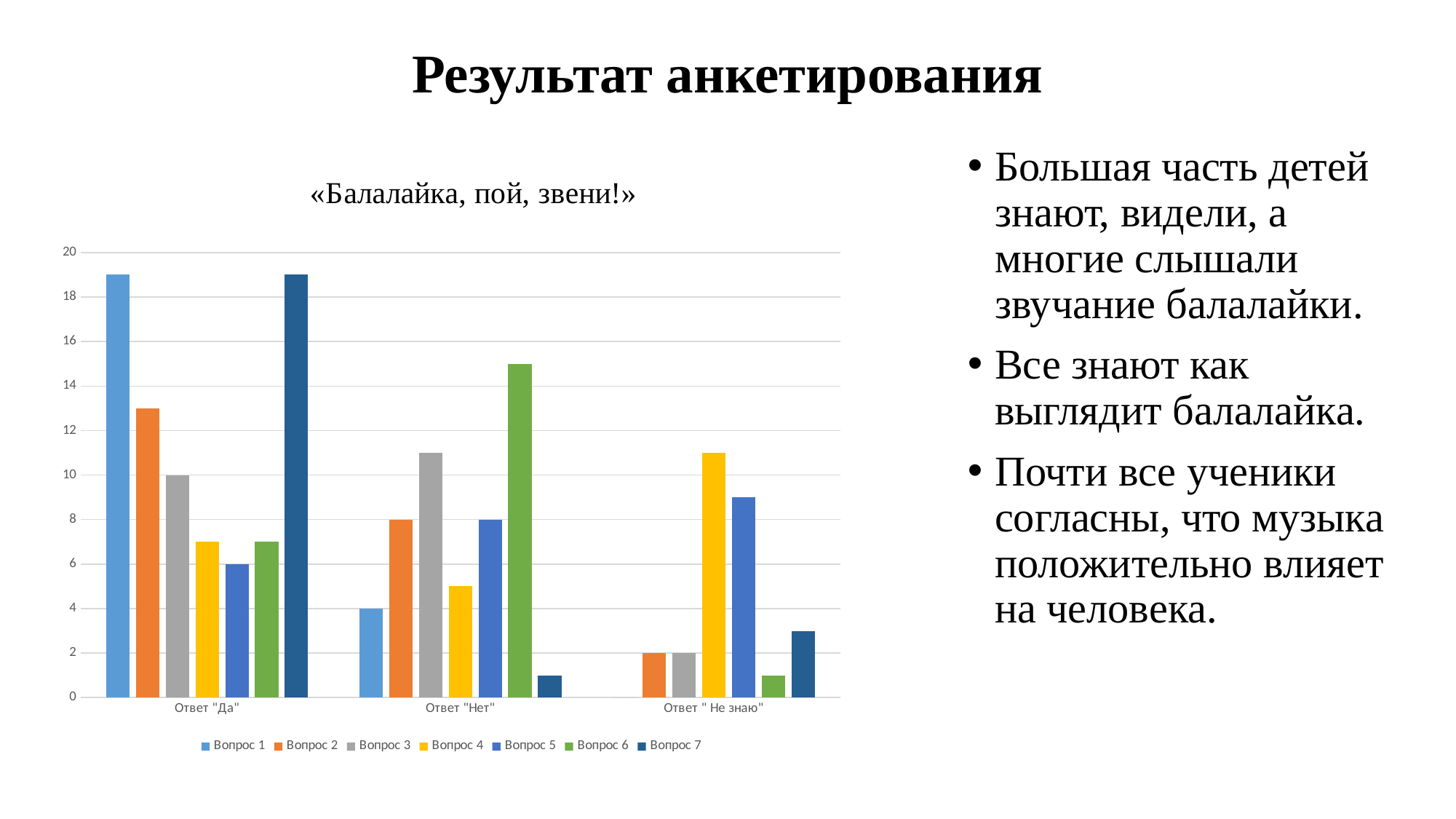
What is the title of the chart? «Балалайка, пой, звени!» What kind of chart is shown on the slide? bar chart Which series has the highest value in the Ответ "Нет" category? Вопрос 6 Is the value for Вопрос 1 in the Ответ "Да" category greater or less than 18? greater What is the value for Вопрос 1 in the Ответ "Нет" category? 4 What is the value for Вопрос 5 in the Ответ "Да" category? 6 How many series does the legend list? 7 Which series has the lowest value in the Ответ "Нет" category? Вопрос 7 How many answer categories are shown on the x axis? 3 What is the value for Вопрос 3 in the Ответ "Да" category? 10 What is the value for Вопрос 2 in the Ответ "Нет" category? 8 In the Ответ " Не знаю" category, which is larger: Вопрос 4 or Вопрос 5? Вопрос 4